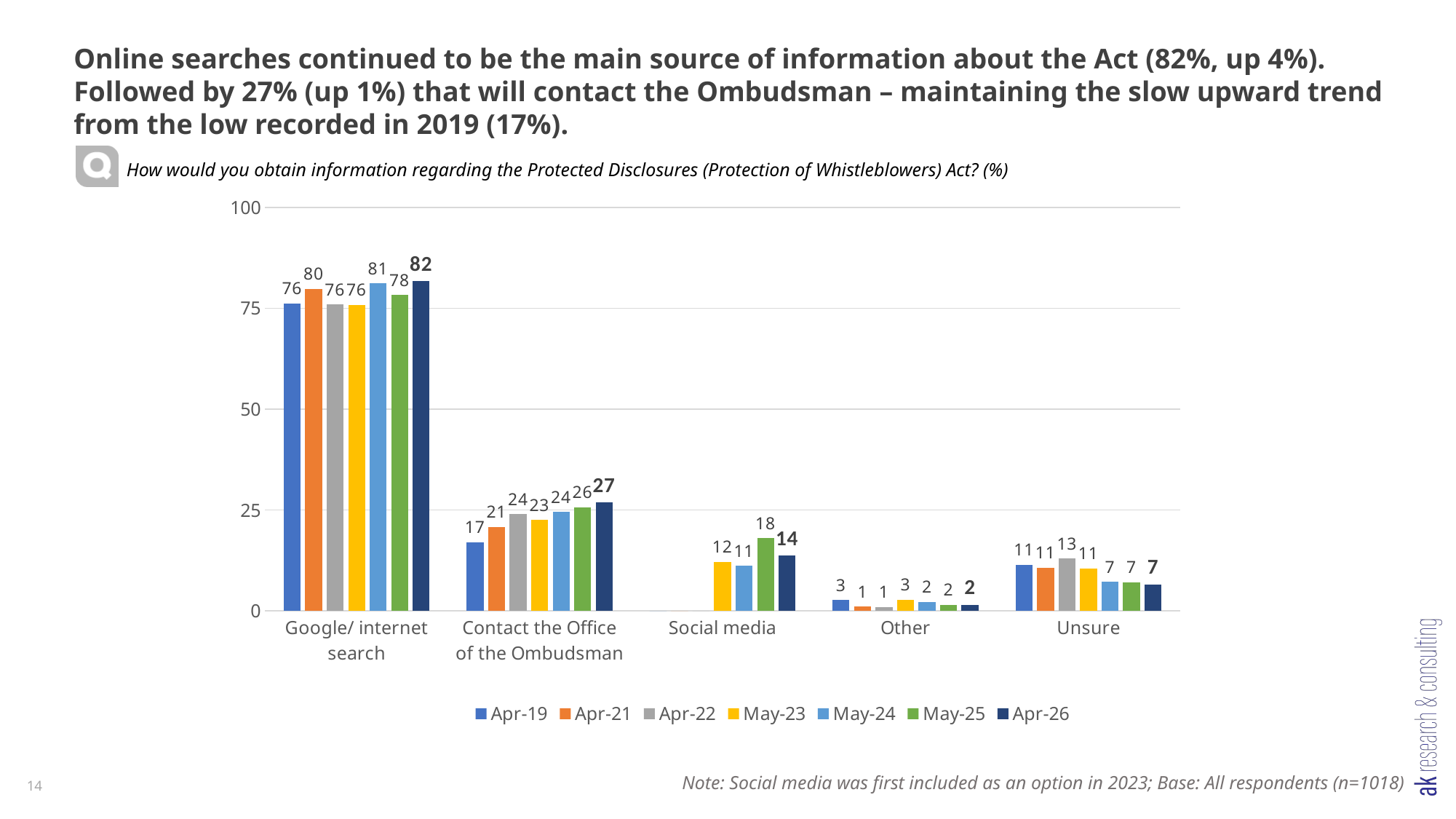
What is the Apr-19 value for Contact the Office of the Ombudsman? 17 Which series is shown in dark navy blue in the legend? Apr-26 How many categories are shown on the x axis? 5 What is the Apr-26 value for Google/ internet search? 82 Which category has the highest Apr-26 value? Google/ internet search What is the Apr-22 value for Unsure? 13 Which is larger for Unsure: the Apr-19 value or the Apr-26 value? Apr-19 What kind of chart is shown on the slide? Bar chart How many series does the legend list? 7 What is the May-25 value for Social media? 18 What is the difference between the Apr-26 and Apr-19 values for Contact the Office of the Ombudsman? 10 Which category has the lowest Apr-26 value? Other